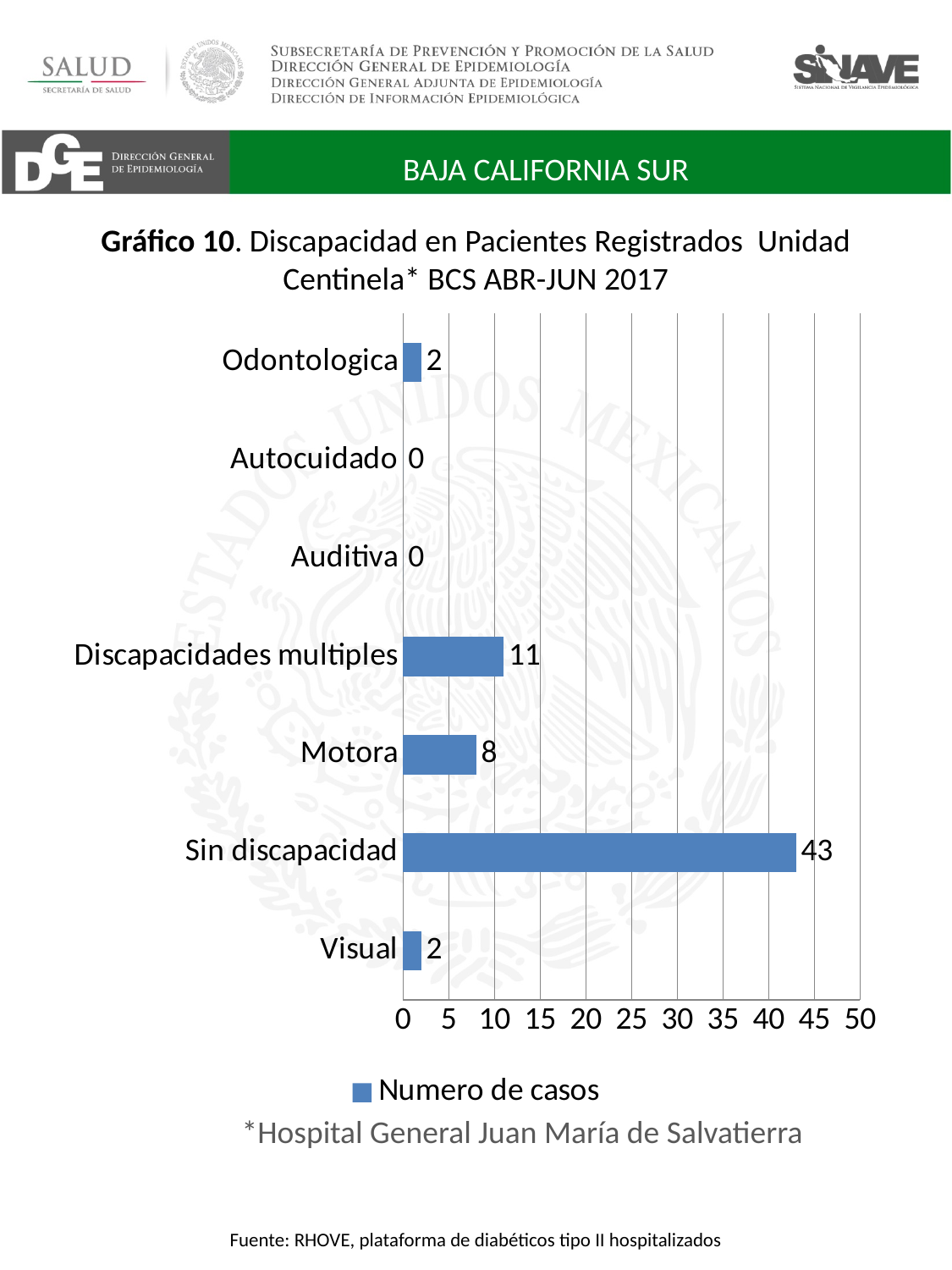
What is the number of cases for Sin discapacidad? 43 Which category has the highest number of cases? Sin discapacidad What series name does the legend show? Numero de casos What is the difference in number of cases between Sin discapacidad and Discapacidades multiples? 32 What kind of chart is shown on the slide? Bar chart How many categories are shown on the chart? 7 What is the number of cases for Odontologica? 2 Which has more cases, Motora or Visual? Motora What is the number of cases for Motora? 8 What is the number of cases for Discapacidades multiples? 11 What is the difference in number of cases between Discapacidades multiples and Motora? 3 Is the value for Sin discapacidad greater or less than 40? greater